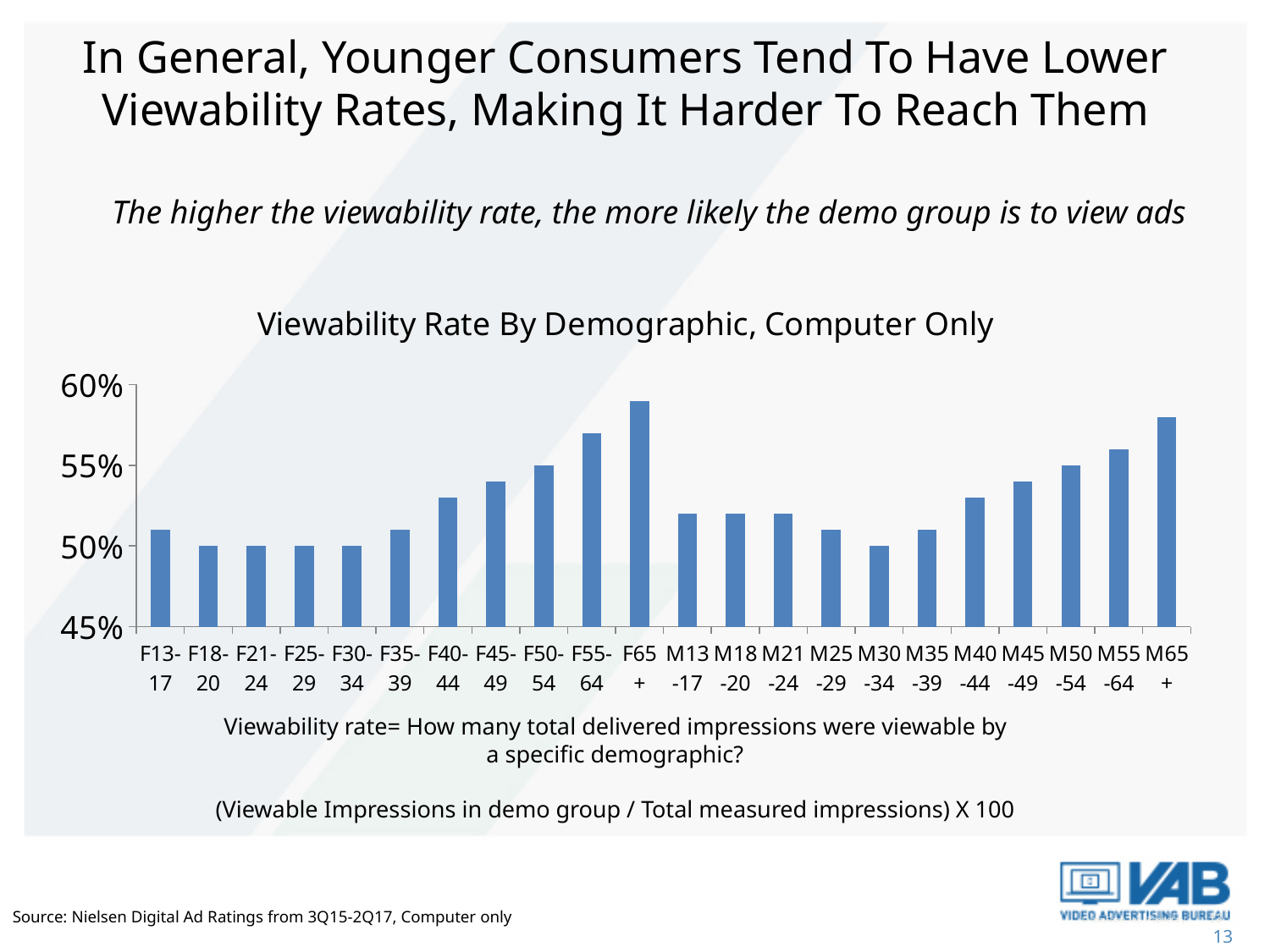
Which demographic group has the highest viewability rate? F65+ Which has a higher viewability rate, F65+ or M13-17? F65+ Is the viewability rate for F65+ greater or less than 55%? greater Is the viewability rate for M65+ greater or less than 55%? greater How many demographic groups are plotted on the x axis? 22 Which has a higher viewability rate, F55-64 or F35-39? F55-64 Is the viewability rate for F13-17 greater or less than 55%? less What is the title of the chart? Viewability Rate By Demographic, Computer Only Among the female demographic groups from F35-39 to F65+, does the viewability rate rise or fall with age? rise What type of chart is shown on the slide? bar chart Which has a higher viewability rate, M65+ or M30-34? M65+